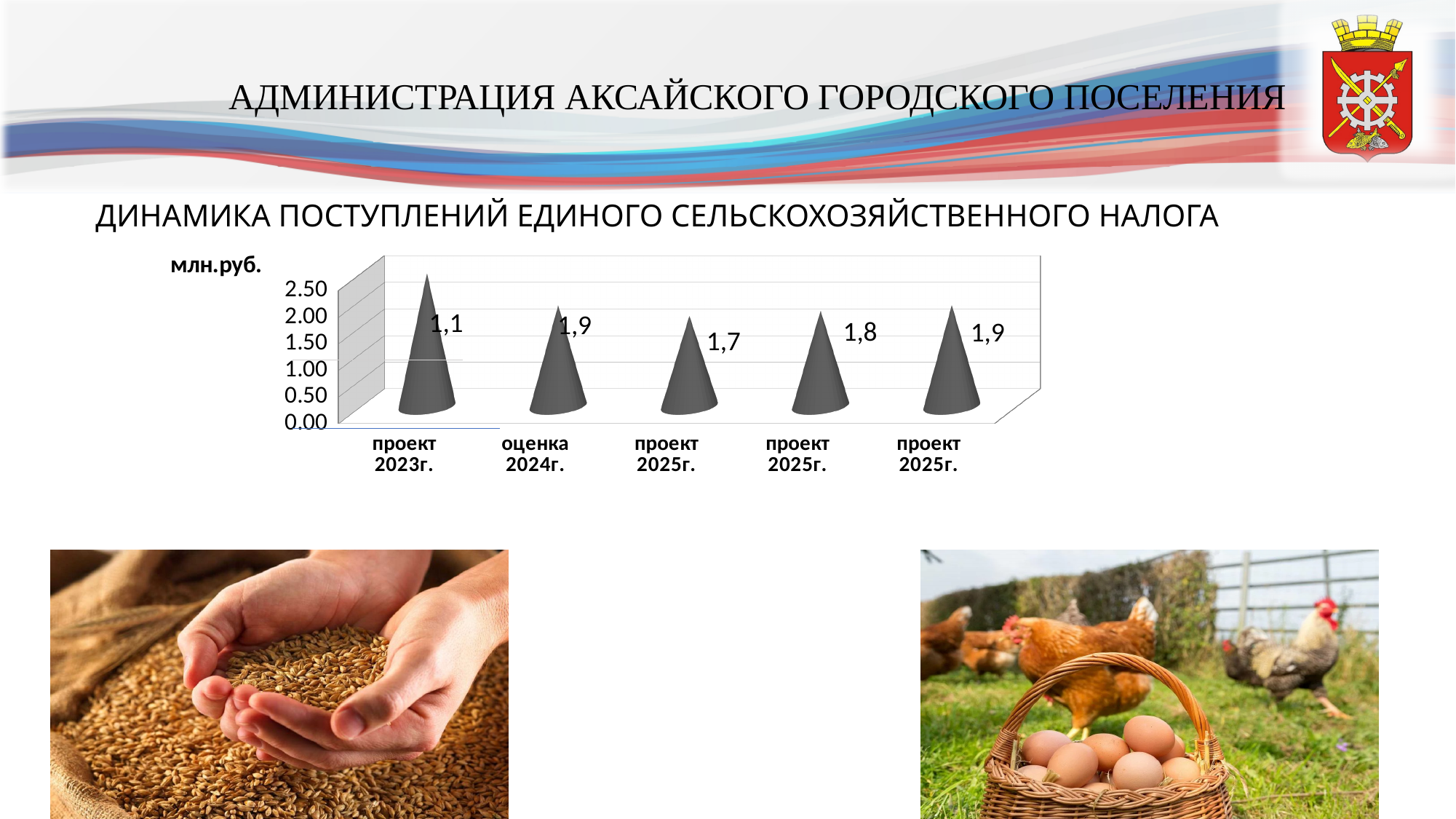
What is the value of the third bar from the left (the first проект 2025г. bar)? 1,7 How many bars are plotted in the chart? 5 What is the value for оценка 2024г.? 1,9 What is the difference between the fourth bar (1,8) and the third bar (1,7)? 0,1 Is the value for оценка 2024г. greater or less than 1.50? greater What is the value for проект 2023г.? 1,1 What is the value of the fourth bar from the left? 1,8 What is the value of the rightmost bar? 1,9 What is the difference between the value for оценка 2024г. and the value for проект 2023г.? 0,8 What kind of chart is shown on the slide? bar chart What unit is shown next to the vertical axis of the chart? млн.руб. Which is larger: the value for оценка 2024г. or the value of the third bar from the left? оценка 2024г.